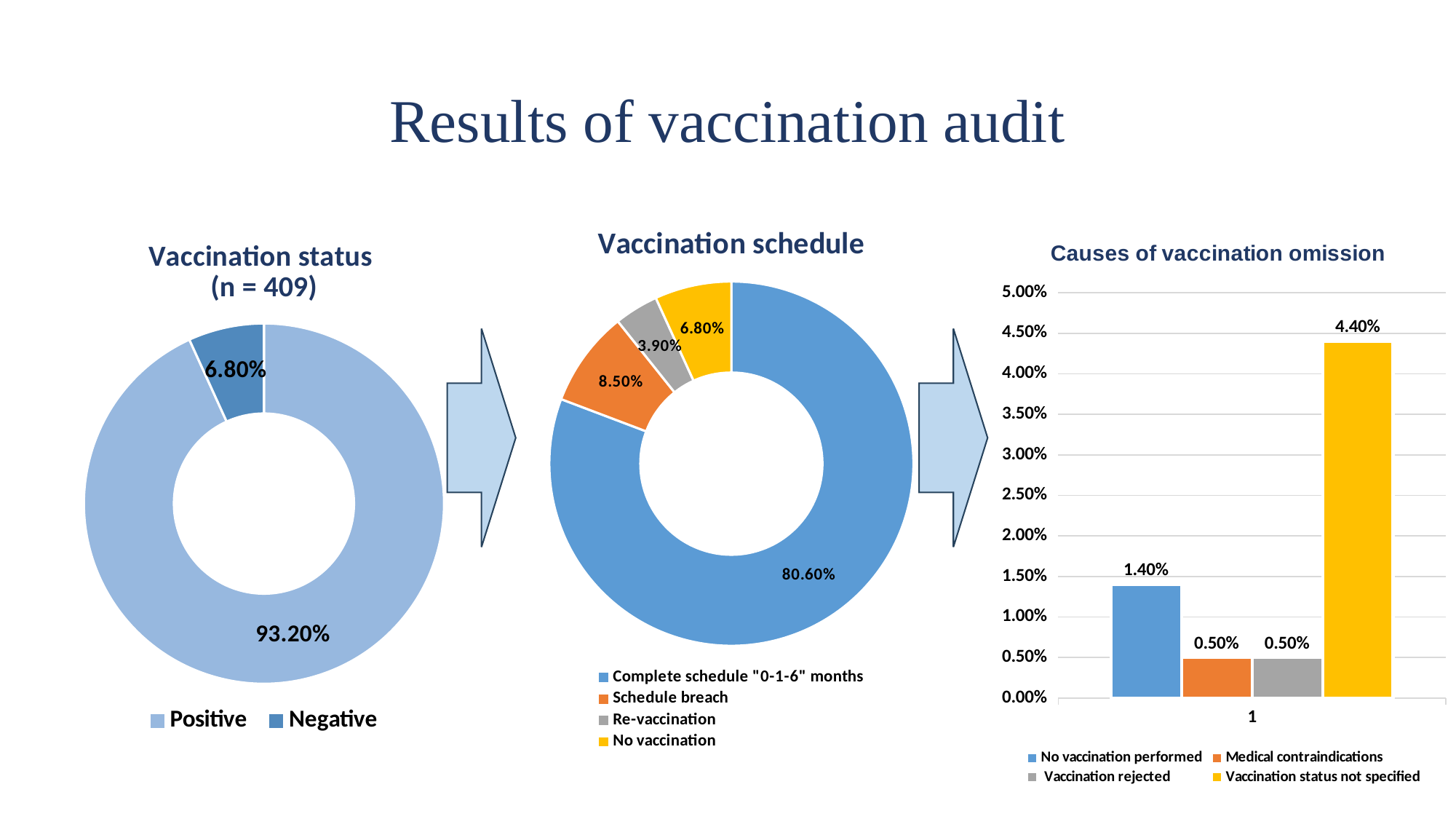
What kind of chart is the 'Causes of vaccination omission' chart? Bar chart In the 'Causes of vaccination omission' chart, which is larger: No vaccination performed or Medical contraindications? No vaccination performed In the 'Vaccination status (n = 409)' chart, what is the value for Positive? 93.20% In the 'Vaccination schedule' chart, which category has the largest share? Complete schedule "0-1-6" months In the 'Vaccination schedule' chart, which category has the smallest share? Re-vaccination In the 'Causes of vaccination omission' chart, what is the value for Vaccination status not specified? 4.40% In the 'Vaccination schedule' chart, what is the value for Schedule breach? 8.50% In the 'Causes of vaccination omission' chart, what is the difference between Vaccination status not specified and No vaccination performed? 3.00% What kind of chart is the 'Vaccination status (n = 409)' chart? Doughnut chart In the 'Vaccination status (n = 409)' chart, what is the value for Negative? 6.80% In the 'Vaccination schedule' chart, what is the value for Re-vaccination? 3.90% How many categories does the legend of the 'Vaccination schedule' chart list? 4